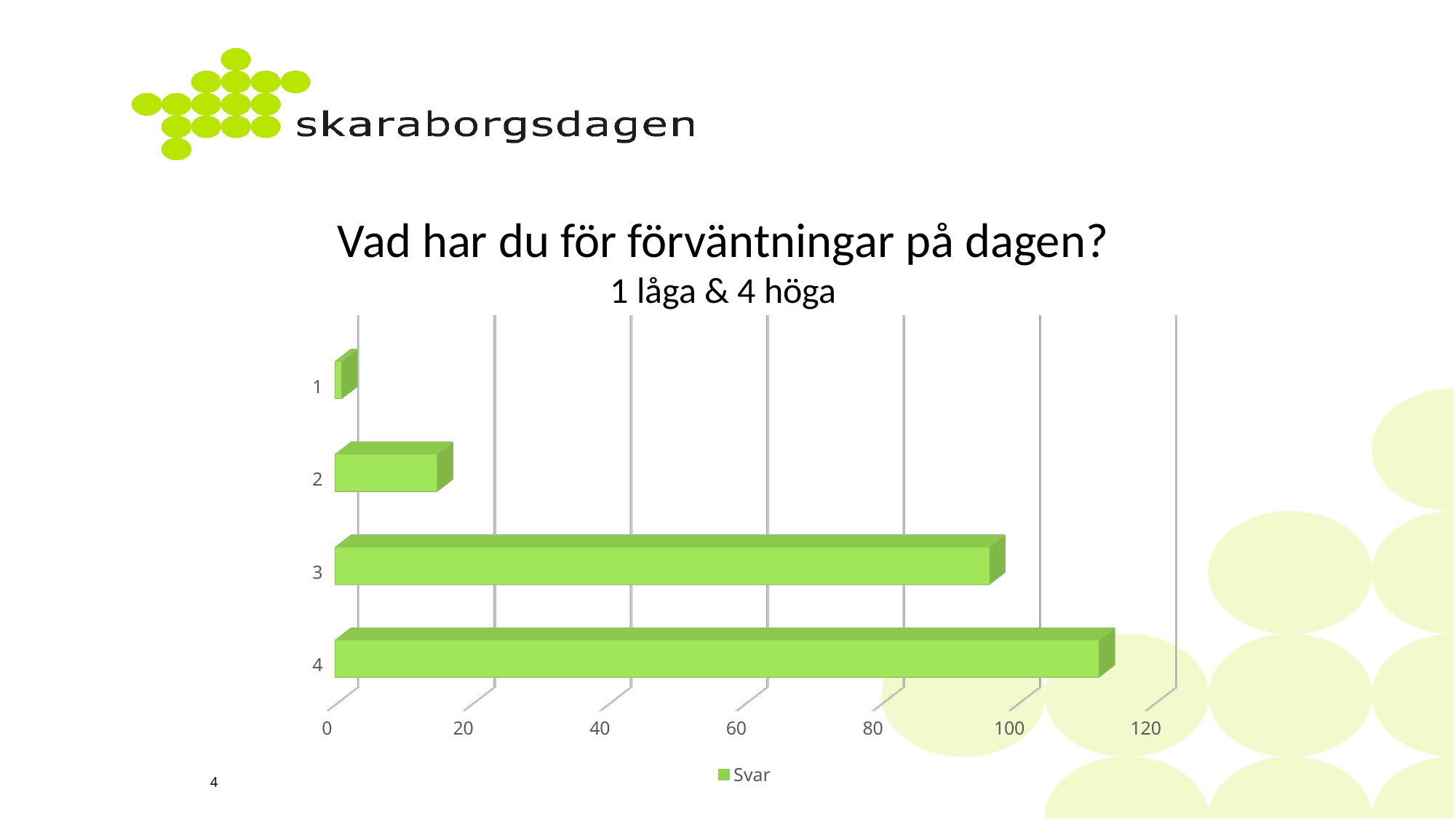
Is the value for category 4 greater or less than 100? greater Which has the larger value, category 2 or category 3? 3 Is the value for category 3 greater or less than 100? less Which category has the lowest value? 1 Which category has the highest value? 4 Do the values rise or fall going from category 1 to category 4? rise How many categories are plotted in the chart? 4 What is the name of the series shown in the legend? Svar Is the value for category 2 greater or less than 20? less What kind of chart is shown on the slide? bar chart How many series does the legend list? 1